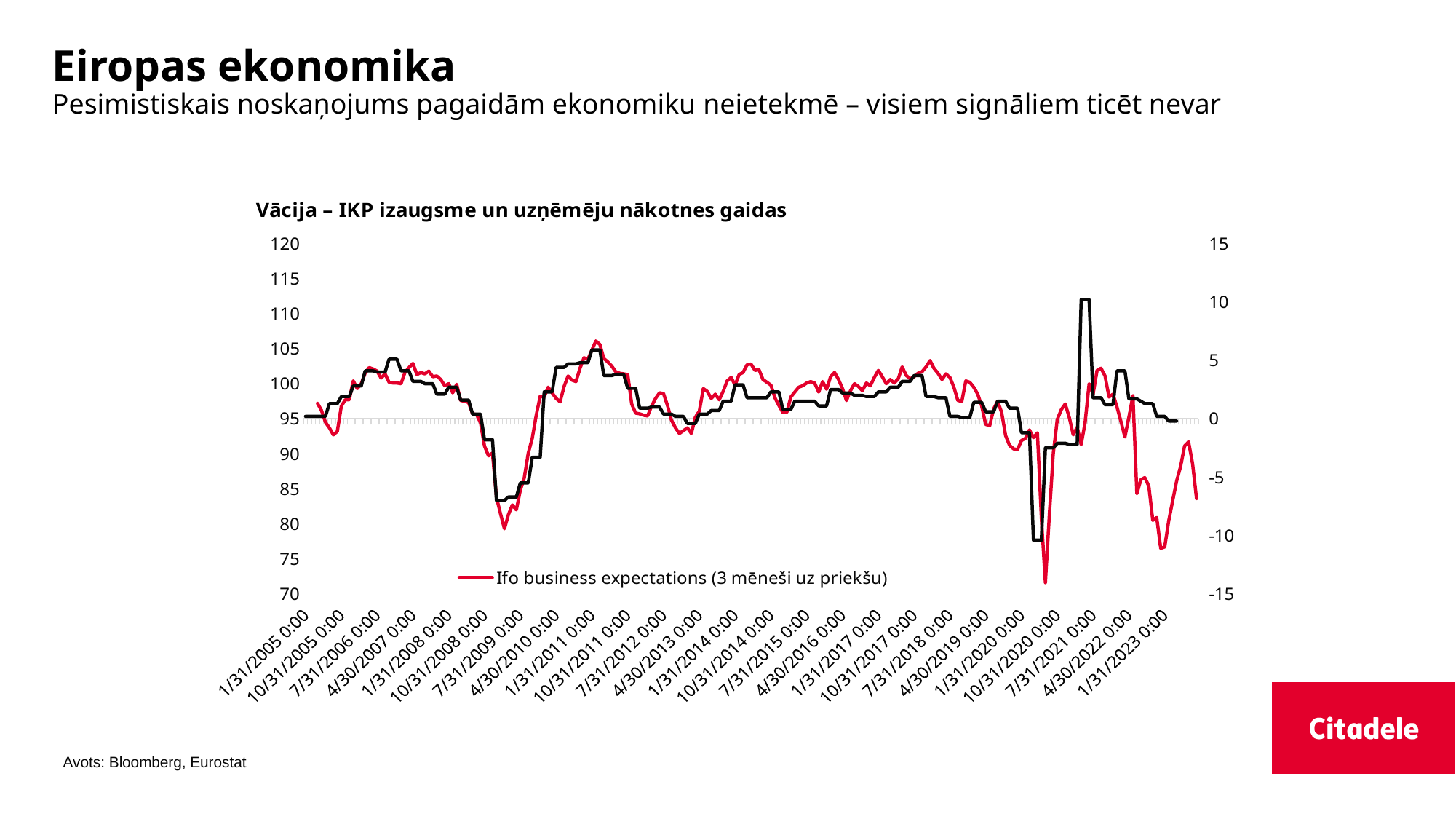
Does the red Ifo business expectations line rise or fall between 10/31/2008 and 7/31/2009? fall Is the value of the red Ifo business expectations line around 7/31/2009 greater or less than 85 on the left axis? less Around which x-axis date does the red Ifo business expectations line reach its lowest point? 10/31/2020 Is the value of the red Ifo business expectations line around 10/31/2020 greater or less than 75 on the left axis? less Is the peak of the black line around 7/31/2021 greater or less than 5 on the right axis? greater Does the red Ifo business expectations line rise or fall between 7/31/2009 and 4/30/2011? rise What colour is the line for Ifo business expectations (3 mēneši uz priekšu)? red How many series does the chart's legend list? 1 What kind of chart is shown on the slide? line chart Is the red Ifo business expectations line higher around 4/30/2011 or around 7/31/2009? 4/30/2011 Around which x-axis date does the black line reach its highest point? 7/31/2021 What is the title of the chart? Vācija – IKP izaugsme un uzņēmēju nākotnes gaidas